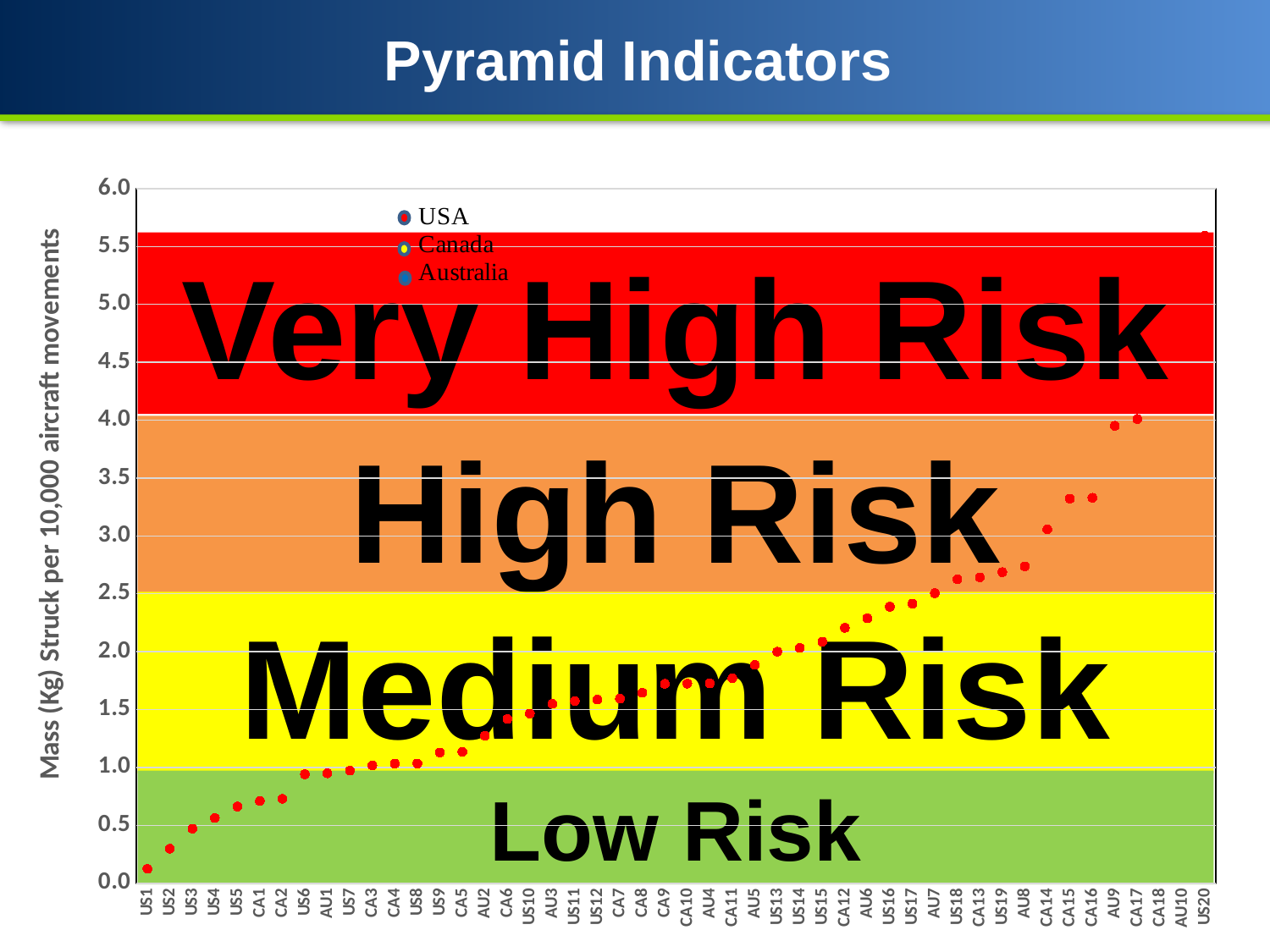
Which category has the lowest value? US1 Which has the larger value, US20 or US1? US20 Do the values rise or fall from left to right along the x axis? rise Which category has the highest value? US20 Which series are listed in the legend? USA, Canada, Australia Is the value for US1 greater or less than 0.5? less What is the y-axis title of the chart? Mass (Kg) Struck per 10,000 aircraft movements Is the value for US20 greater or less than 5.0? greater Is the value for AU9 greater or less than 3.5? greater What kind of chart is shown on the slide? scatter chart How many series does the legend list? 3 How many categories are shown along the x axis? 48